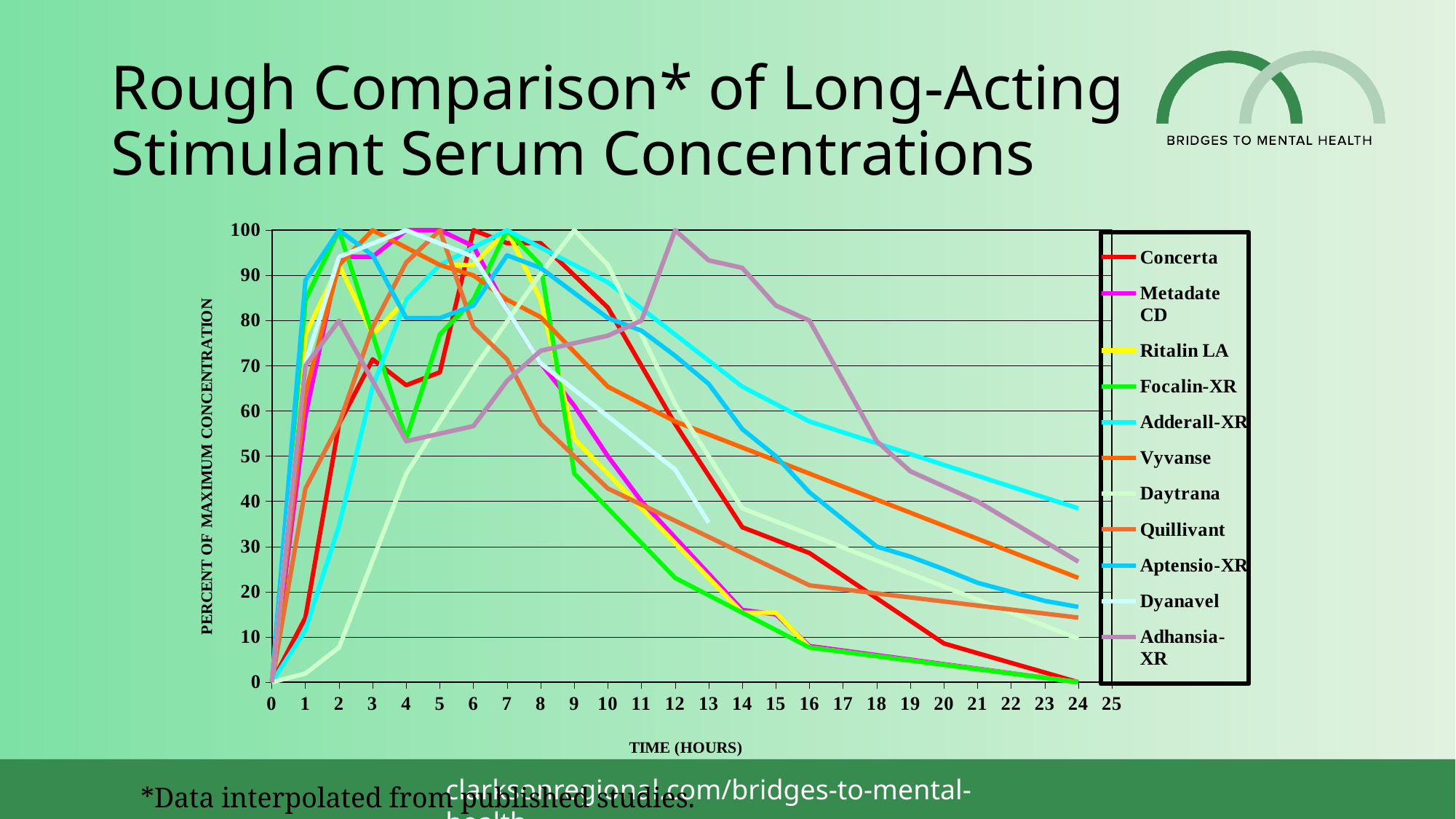
What is the title of the chart's x axis? TIME (HOURS) How many series does the legend list? 11 Does the Concerta line rise or fall between hour 6 and hour 24? fall Which series reaches its peak of 100 at hour 12? Adhansia-XR At hour 24, which is larger: the value for Adderall-XR or the value for Concerta? Adderall-XR Is the value for Adhansia-XR at hour 24 greater or less than 20? greater What is the value for Adhansia-XR at hour 12? 100 What is the value for Concerta at hour 0? 0 What kind of chart is shown on the slide? line chart What is the title of the chart's y axis? PERCENT OF MAXIMUM CONCENTRATION Is the value for Focalin-XR at hour 12 greater or less than 30? less Is the value for Concerta at hour 14 greater or less than 40? less